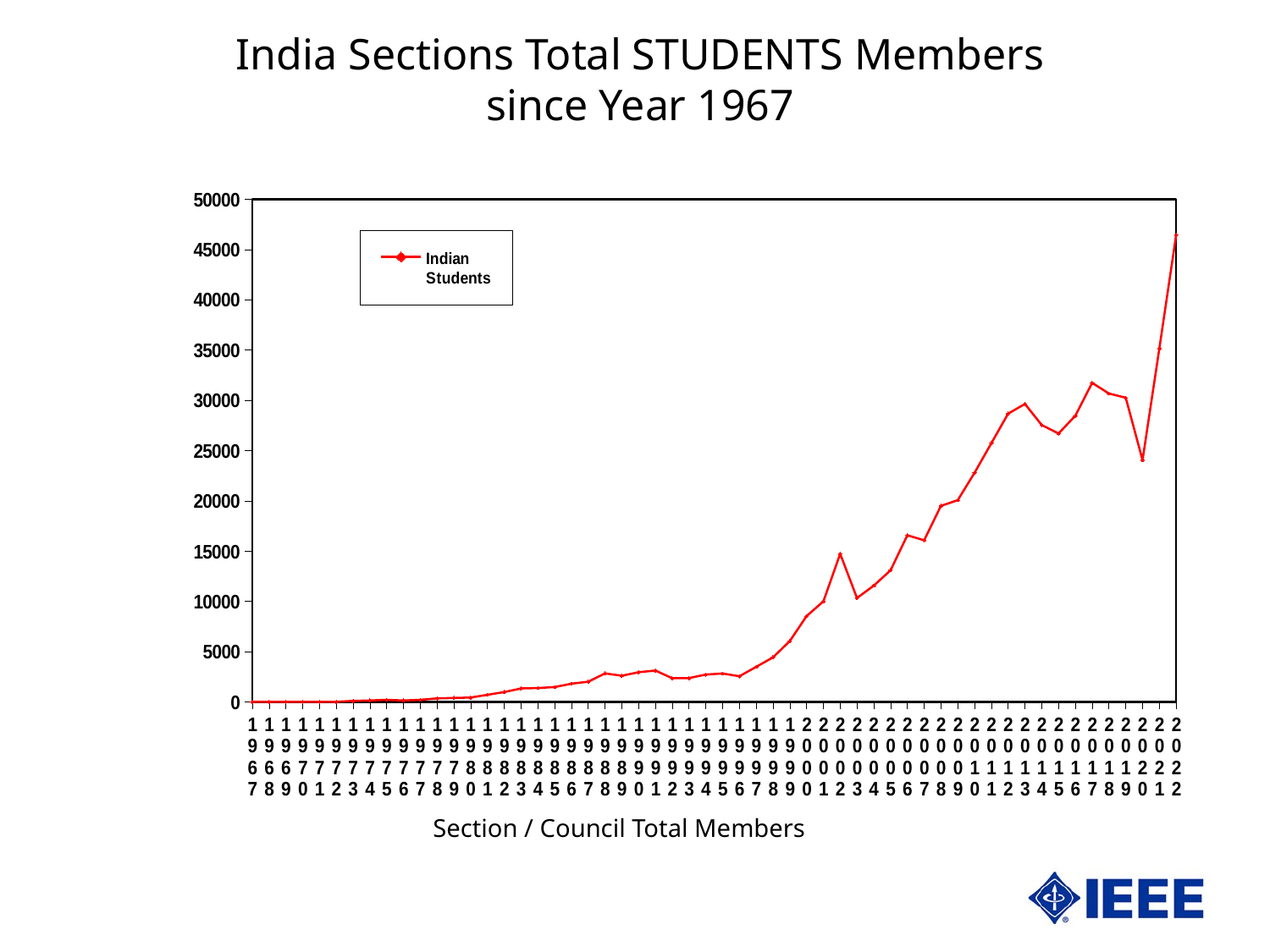
Is the value for 2002 greater or less than 10000? greater Which year has the highest number of Indian Students? 2022 Which year has the larger value, 2002 or 2003? 2002 How many series does the legend list? 1 Which year has the larger value, 2017 or 2020? 2017 Is the value for 2020 greater or less than 30000? less Is the value for 2022 greater or less than 40000? greater What is the name of the series shown in the legend? Indian Students Overall, do the values rise or fall from 1967 to 2022? rise What is the title of the chart? India Sections Total STUDENTS Members since Year 1967 What kind of chart is shown on the slide? line chart